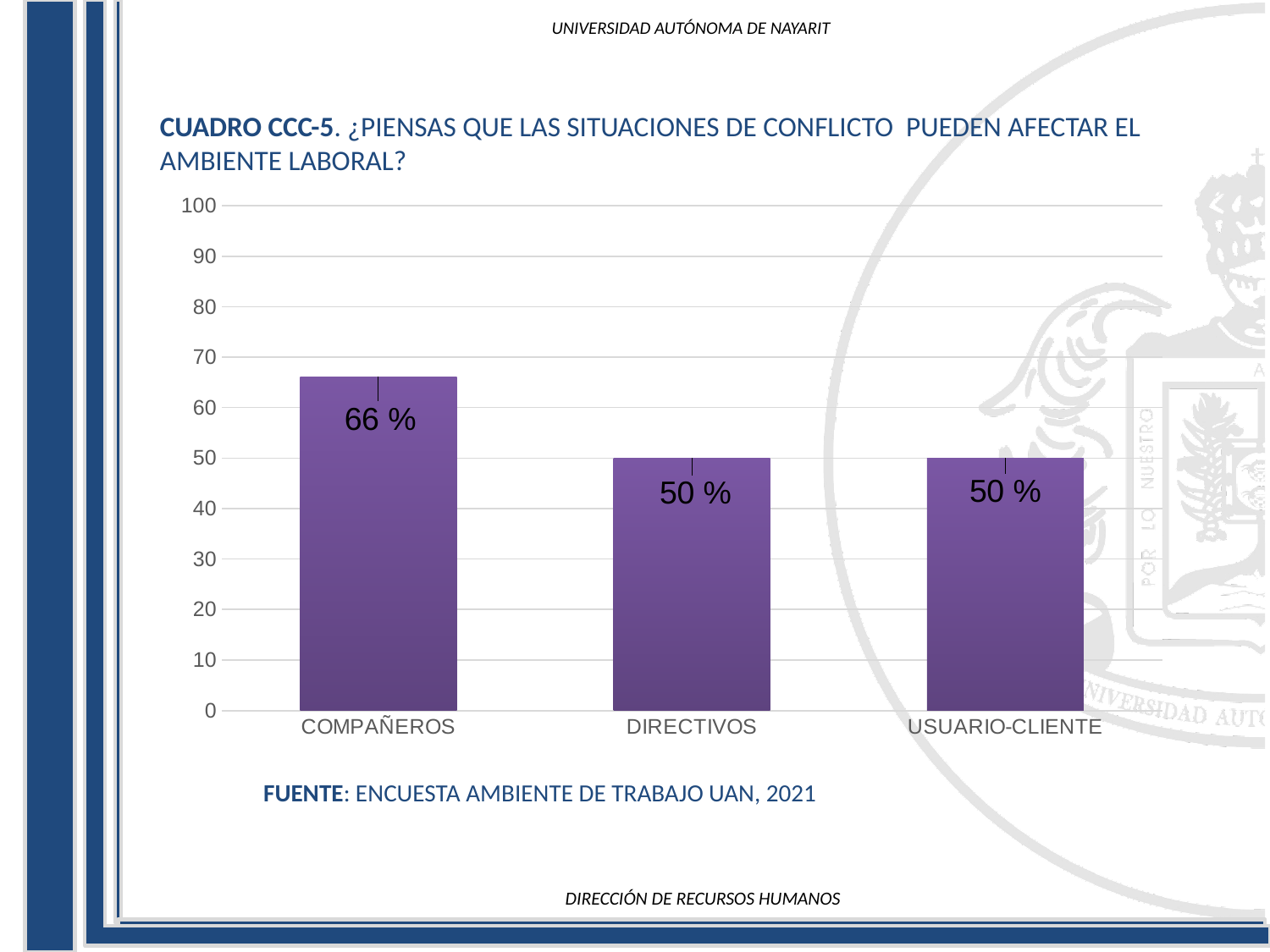
What is the value for COMPAÑEROS? 66 % Which category has the highest value? COMPAÑEROS How many categories are shown on the x axis? 3 What is the value for USUARIO-CLIENTE? 50 % What is the maximum value shown on the vertical axis? 100 Which is larger, the value for COMPAÑEROS or the value for USUARIO-CLIENTE? COMPAÑEROS Is the value for DIRECTIVOS greater or less than 70? less Is the value for COMPAÑEROS greater or less than 60? greater What is the difference between the values for COMPAÑEROS and DIRECTIVOS? 16 % What source is cited below the chart? ENCUESTA AMBIENTE DE TRABAJO UAN, 2021 What is the value for DIRECTIVOS? 50 % What kind of chart is shown on the slide? bar chart